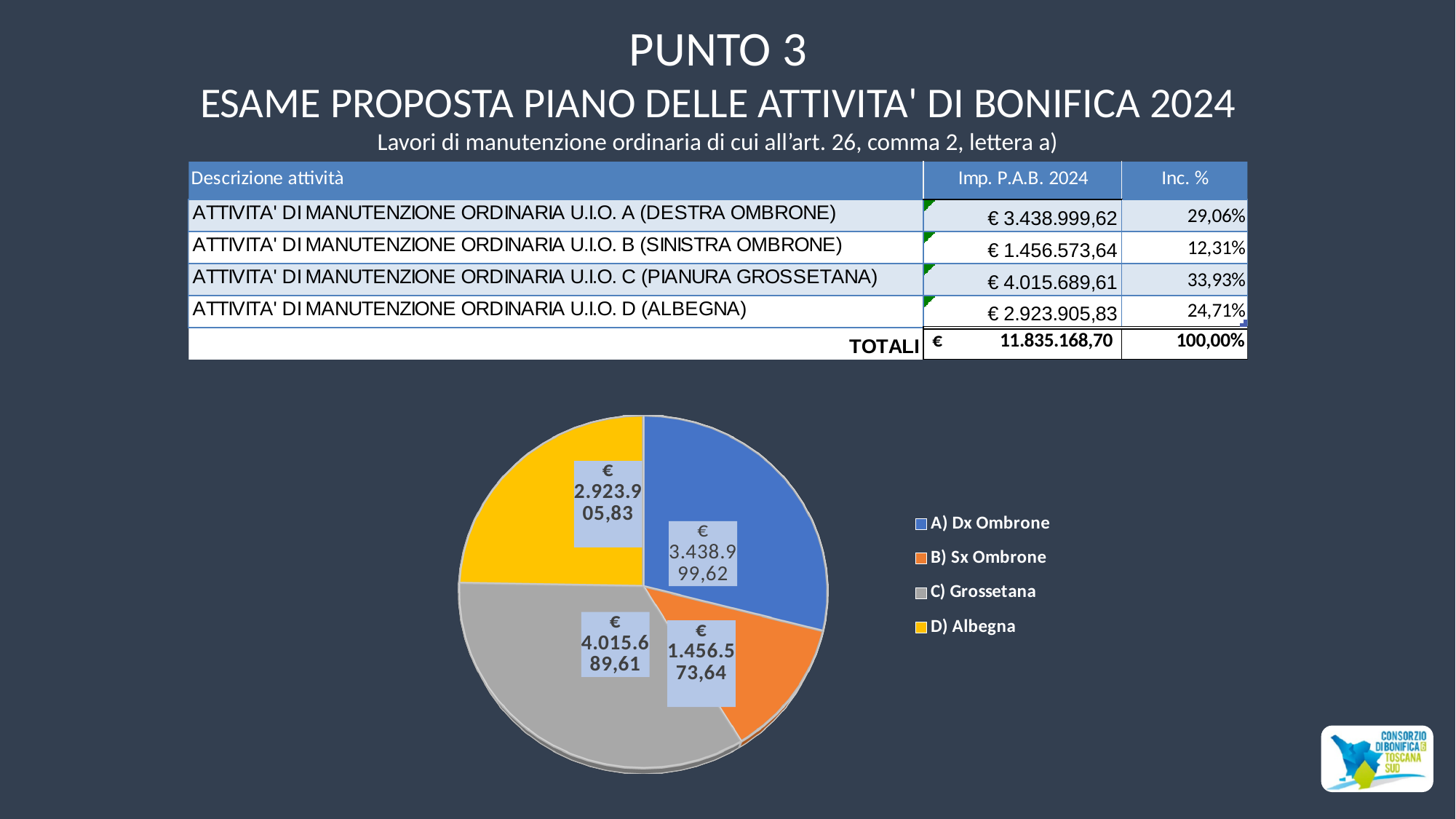
What is the value shown for B) Sx Ombrone in the pie chart? € 1.456.573,64 How many slices does the pie chart have? 4 What is the value shown for C) Grossetana in the pie chart? € 4.015.689,61 What is the value shown for A) Dx Ombrone in the pie chart? € 3.438.999,62 What is the value shown for D) Albegna in the pie chart? € 2.923.905,83 Which category has the smallest slice in the pie chart? B) Sx Ombrone What type of chart is shown on the slide? pie chart What share of the total does C) Grossetana represent, according to the slide? 33,93% Which category has the largest slice in the pie chart? C) Grossetana Which is larger in the pie chart, the value for D) Albegna or the value for B) Sx Ombrone? D) Albegna What colour is the slice for D) Albegna in the pie chart? yellow What is the difference between the values for C) Grossetana and A) Dx Ombrone in the pie chart? € 576.689,99